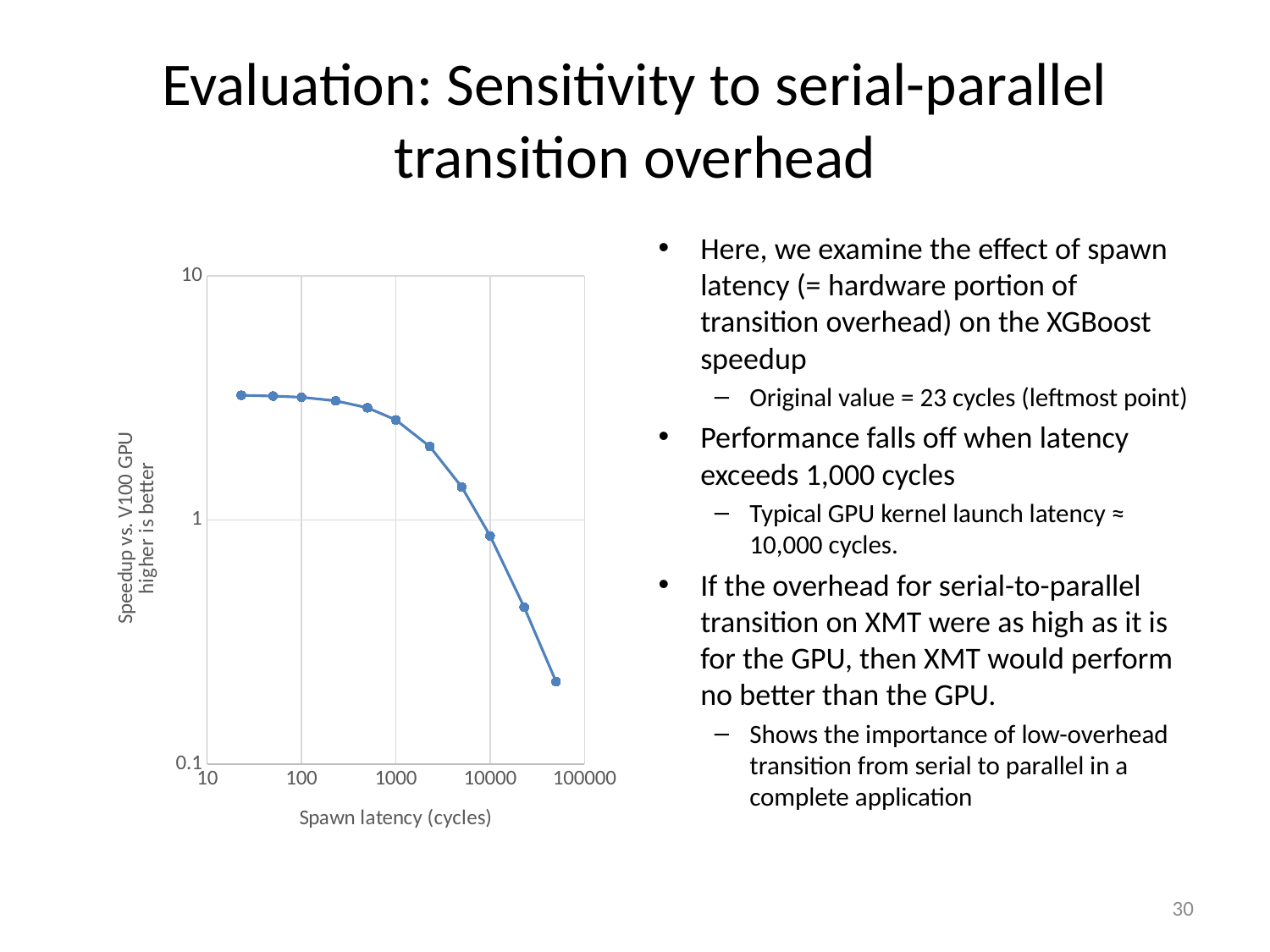
Is the speedup at a spawn latency of 1000 cycles greater or less than 1? greater What is the title of the y axis of the chart? Speedup vs. V100 GPU higher is better Which is larger: the speedup at 100 cycles or the speedup at 10000 cycles? the speedup at 100 cycles Is the speedup at the leftmost point greater or less than 10? less How many data points are plotted on the line? 11 Does the speedup rise or fall as spawn latency increases along the x axis? fall Is the speedup at the rightmost point greater or less than 0.1? greater What is the title of the x axis of the chart? Spawn latency (cycles) What kind of chart is shown on the slide? line chart Which point has the highest speedup: the one at the lowest spawn latency or the one at the highest spawn latency? the one at the lowest spawn latency